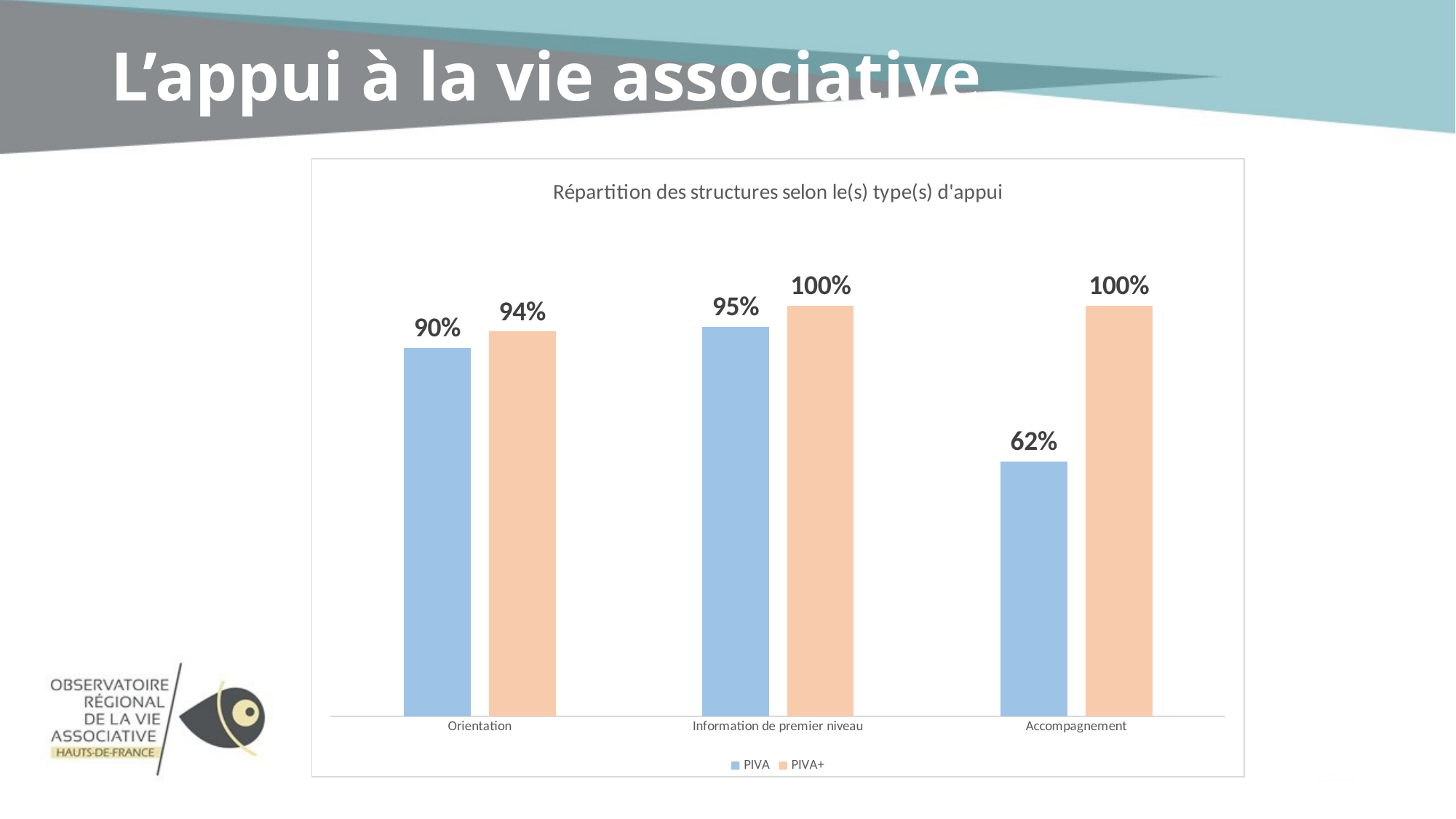
What is the PIVA value for Orientation? 90% What type of chart is shown? Bar chart Which category has the lowest PIVA value? Accompagnement What is the PIVA value for Accompagnement? 62% What is the difference between the PIVA+ and PIVA values for Accompagnement? 38% What is the PIVA value for Information de premier niveau? 95% How many series does the legend list? 2 Which category has the highest PIVA value? Information de premier niveau How many categories are shown on the x axis? 3 What is the PIVA+ value for Orientation? 94% Which is larger for Orientation, the PIVA value or the PIVA+ value? PIVA+ What is the PIVA+ value for Accompagnement? 100%